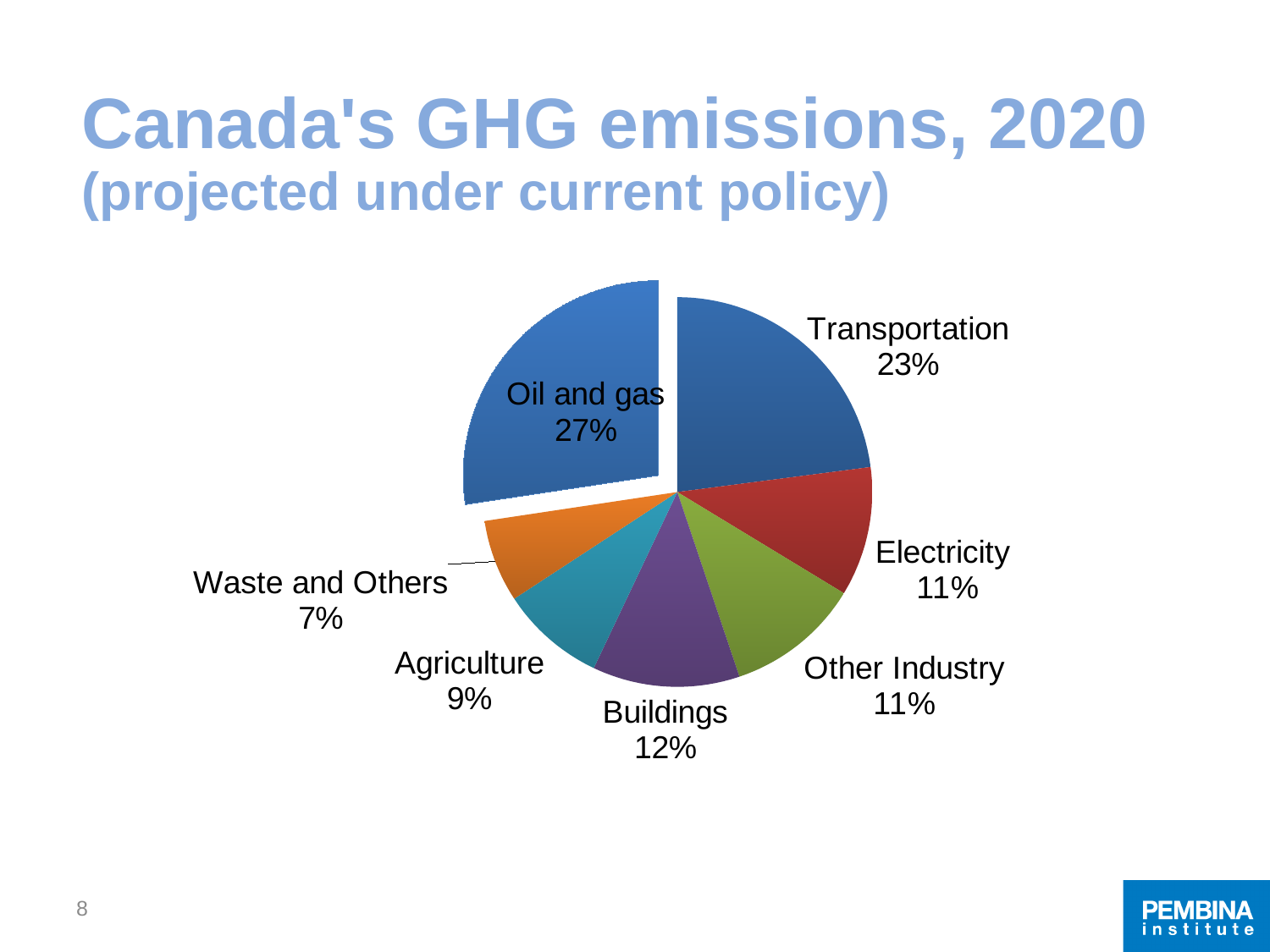
What is the difference in percentage points between Oil and gas and Transportation? 4 percentage points What type of chart is shown on the slide? Pie chart Which sector has the smallest share of emissions? Waste and Others What percentage is shown for Waste and Others? 7% What share of emissions is attributed to Transportation? 23% What percentage of emissions comes from Buildings? 12% Which has a larger share, Buildings or Agriculture? Buildings What share of emissions comes from Agriculture? 9% What share of Canada's projected 2020 GHG emissions comes from Oil and gas? 27% Which slice is pulled out (exploded) from the rest of the pie? Oil and gas How many sectors are shown in the pie chart? 7 Which sector has the largest share of emissions? Oil and gas